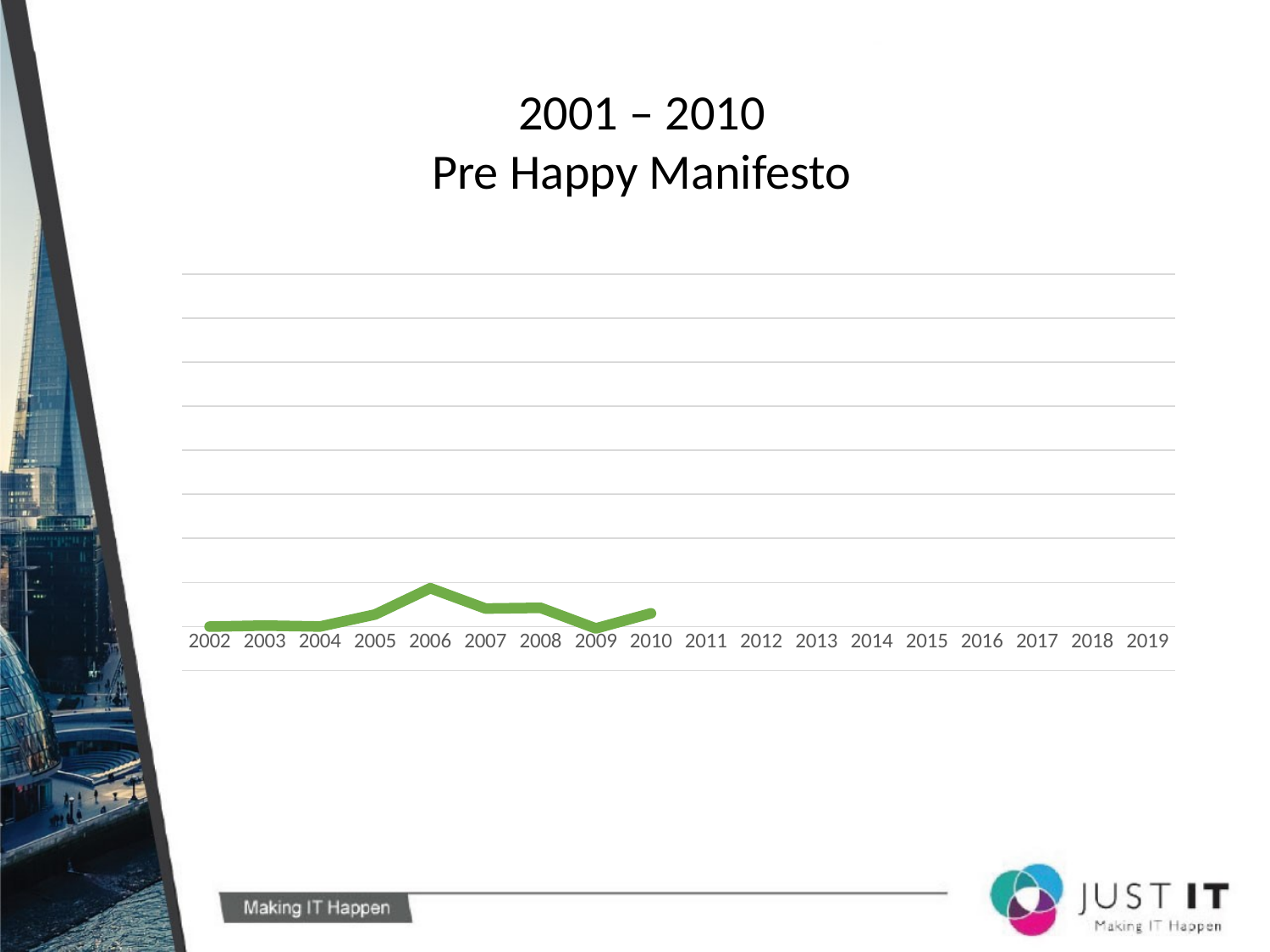
What is the last year for which the line has a plotted value? 2010 Is the value for 2006 larger or smaller than the value for 2008? larger How many year labels are shown on the x axis of the chart? 18 What is the title of the slide above the chart? 2001 – 2010 Pre Happy Manifesto What colour is the plotted line in the chart? green Does the line rise or fall between 2003 and 2006? rise What is the last year label on the x axis? 2019 In which year does the line reach its highest point? 2006 Does the line rise or fall between 2006 and 2009? fall What kind of chart is shown on the slide? line chart What is the first year label on the x axis? 2002 Is the value for 2010 larger or smaller than the value for 2009? larger